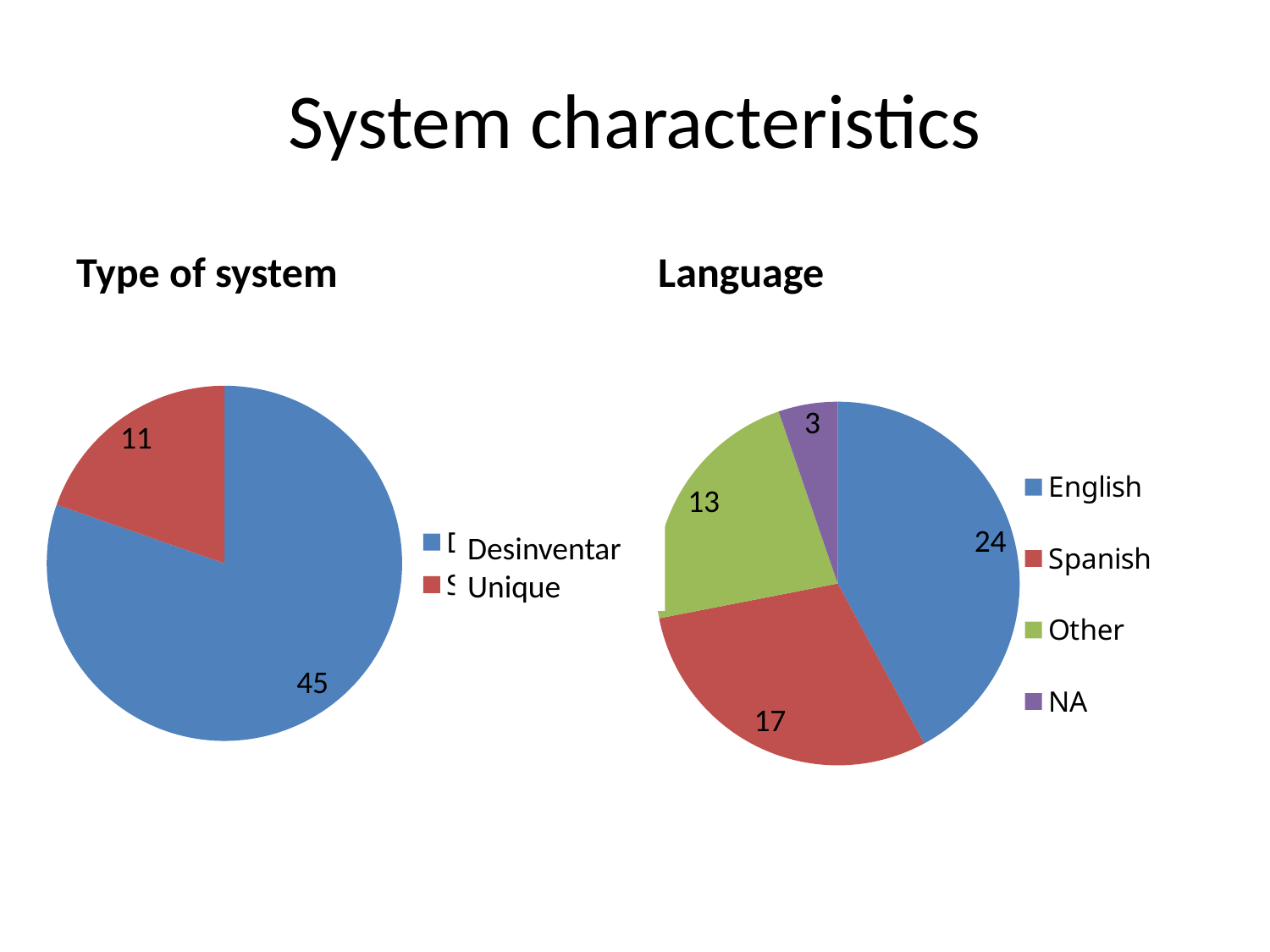
In the Type of system chart, what is the total of all slices? 56 How many categories does the Language chart show? 4 In the Language chart, what is the difference between English and Spanish? 7 In the Language chart, which is larger, Spanish or Other? Spanish In the Language chart, what is the value for Spanish? 17 In the Type of system chart, what is the difference between Desinventar and Unique? 34 In the Language chart, which category has the largest slice? English What type of chart is the Language chart? Pie chart In the Type of system chart, what is the value for Desinventar? 45 In the Language chart, what is the value for Other? 13 In the Language chart, which category has the smallest slice? NA In the Type of system chart, what is the value for Unique? 11